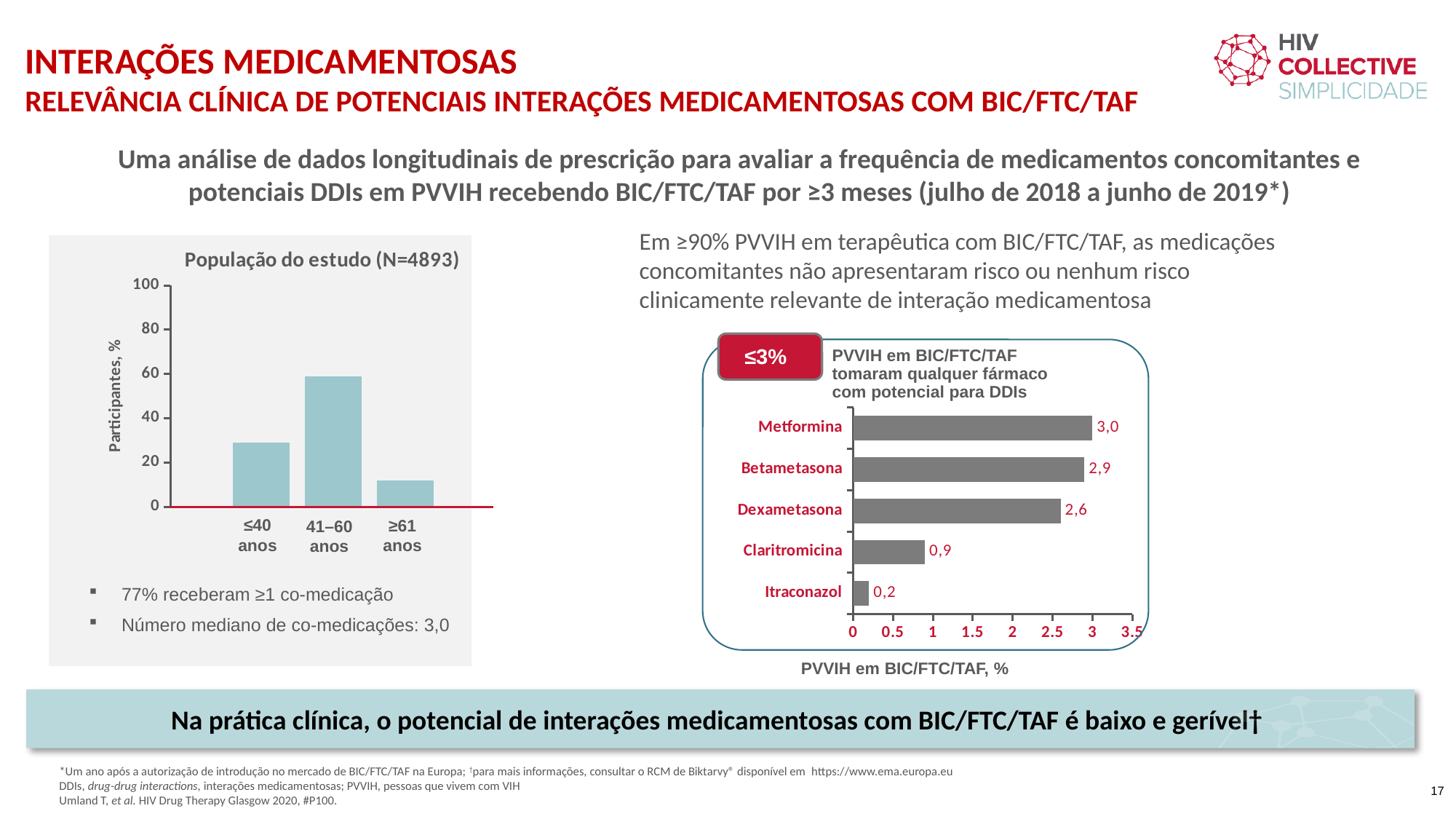
What kind of chart is the chart titled 'População do estudo (N=4893)'? Bar chart In the chart titled 'PVVIH em BIC/FTC/TAF tomaram qualquer fármaco com potencial para DDIs', which drug has the highest value? Metformina In the chart titled 'PVVIH em BIC/FTC/TAF tomaram qualquer fármaco com potencial para DDIs', which drug has the lowest value? Itraconazol How many drugs are shown in the chart titled 'PVVIH em BIC/FTC/TAF tomaram qualquer fármaco com potencial para DDIs'? 5 In the chart titled 'População do estudo (N=4893)', is the value for 41–60 anos greater or less than 40? greater In the chart titled 'População do estudo (N=4893)', which age group has the lowest percentage of participants? ≥61 anos In the chart titled 'PVVIH em BIC/FTC/TAF tomaram qualquer fármaco com potencial para DDIs', which is larger: the value for Betametasona or the value for Claritromicina? Betametasona In the chart titled 'PVVIH em BIC/FTC/TAF tomaram qualquer fármaco com potencial para DDIs', what is the value for Metformina? 3,0 In the chart titled 'População do estudo (N=4893)', which age group has the highest percentage of participants? 41–60 anos In the chart titled 'PVVIH em BIC/FTC/TAF tomaram qualquer fármaco com potencial para DDIs', what is the difference between the values for Dexametasona and Itraconazol? 2,4 What is the x-axis label of the chart titled 'PVVIH em BIC/FTC/TAF tomaram qualquer fármaco com potencial para DDIs'? PVVIH em BIC/FTC/TAF, % In the chart titled 'PVVIH em BIC/FTC/TAF tomaram qualquer fármaco com potencial para DDIs', what is the value for Claritromicina? 0,9